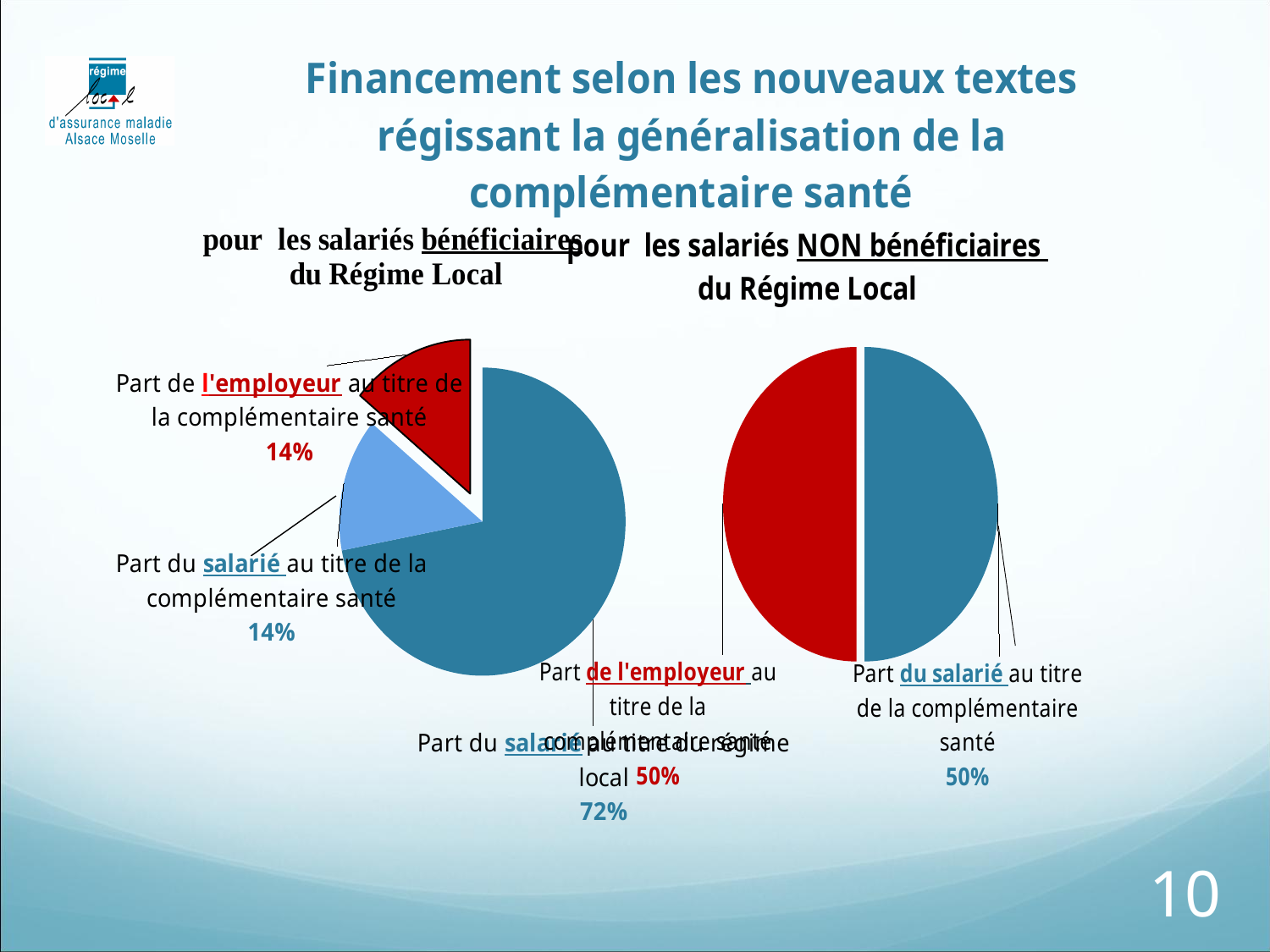
How many pie charts are shown on the slide? 2 In the right pie chart (salariés NON bénéficiaires du Régime Local), how many slices are there? 2 In the left pie chart (salariés bénéficiaires du Régime Local), what is the share of the part du salarié au titre de la complémentaire santé? 14% What kind of chart is used for the salariés bénéficiaires du Régime Local? Pie chart In the left pie chart (salariés bénéficiaires du Régime Local), what is the share of the part de l'employeur au titre de la complémentaire santé? 14% In the left pie chart (salariés bénéficiaires du Régime Local), what is the difference between the part du salarié au titre du régime local and the part de l'employeur au titre de la complémentaire santé? 58% In the left pie chart (salariés bénéficiaires du Régime Local), which slice is the largest? Part du salarié au titre du régime local In the left pie chart (salariés bénéficiaires du Régime Local), how many slices are there? 3 In the right pie chart (salariés NON bénéficiaires du Régime Local), what is the share of the part de l'employeur au titre de la complémentaire santé? 50% In the left pie chart (salariés bénéficiaires du Régime Local), what colour is the slice for the part de l'employeur au titre de la complémentaire santé? Red In the left pie chart (salariés bénéficiaires du Régime Local), what is the share of the part du salarié au titre du régime local? 72% In the right pie chart (salariés NON bénéficiaires du Régime Local), what is the share of the part du salarié au titre de la complémentaire santé? 50%